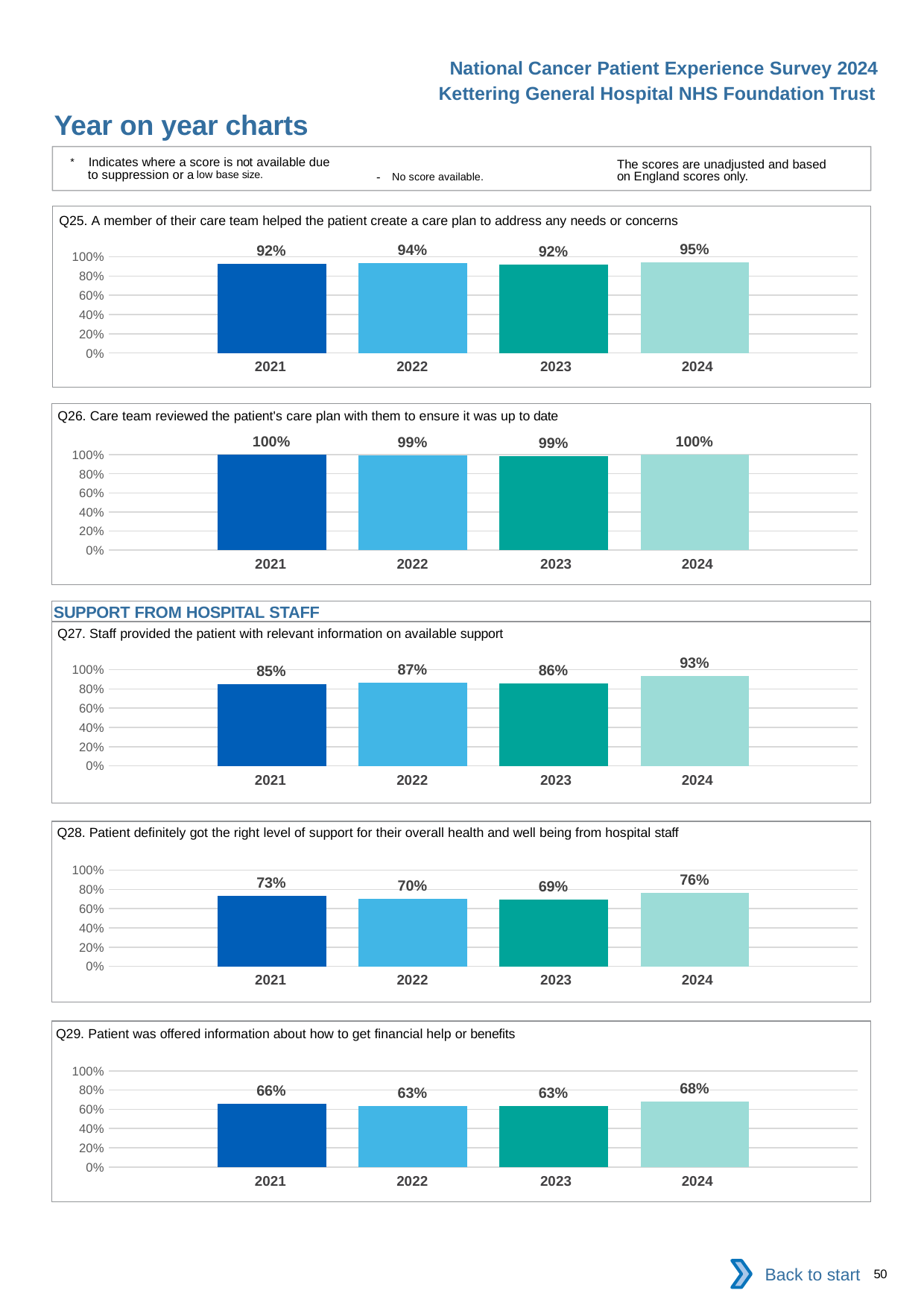
In the Q29 chart, what is the value for 2021? 66% In the Q28 chart, what is the difference between the 2021 and 2022 values? 3 percentage points How many bars are plotted in the Q27 chart? 4 In the Q26 chart, which years have the highest value? 2021 and 2024 In the Q25 chart, what is the value for 2024? 95% What is the section heading shown above the Q27 chart? SUPPORT FROM HOSPITAL STAFF What kind of chart is the Q25 chart? bar chart In the Q27 chart, what is the difference between the 2024 and 2021 values? 8 percentage points In the Q28 chart, which year has the lowest value? 2023 In the Q29 chart, is the value for 2024 greater or less than 60%? greater In the Q27 chart, which year has the highest value? 2024 In the Q28 chart, is the value for 2022 larger or smaller than the value for 2024? smaller